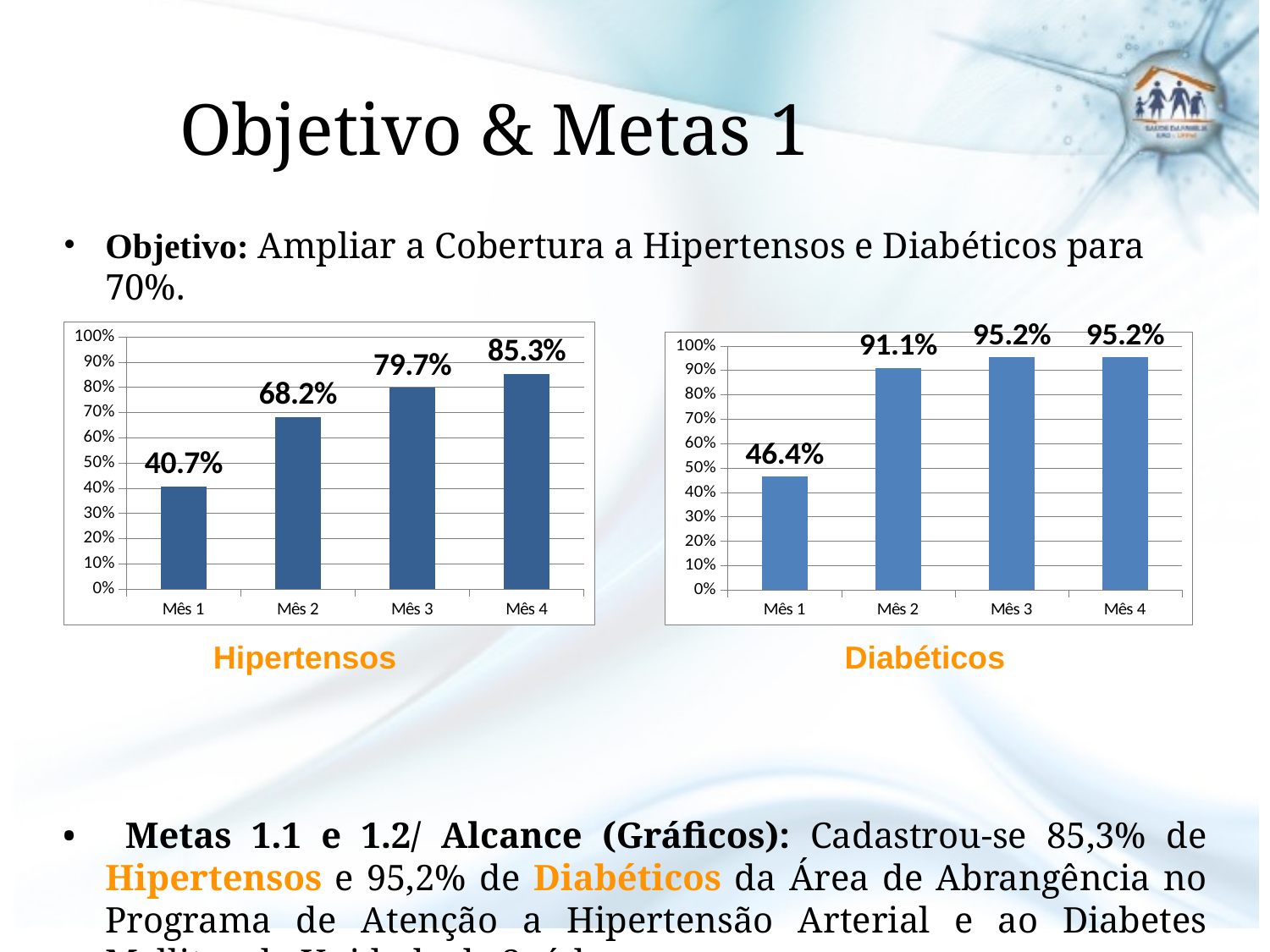
In the Hipertensos chart, do the values rise or fall from Mês 1 to Mês 4? rise Which is larger: the Mês 3 value in the Hipertensos chart or the Mês 3 value in the Diabéticos chart? Diabéticos In the Diabéticos chart, what is the value for Mês 2? 91.1% What kind of chart is the Hipertensos chart? bar chart In the Hipertensos chart, is the value for Mês 2 greater or less than 70%? less In the Hipertensos chart, what is the difference between the values for Mês 4 and Mês 1? 44.6% In the Diabéticos chart, which month has the lowest value? Mês 1 In the Diabéticos chart, what is the difference between the values for Mês 2 and Mês 1? 44.7% How many months are shown in the Diabéticos chart? 4 In the Hipertensos chart, what is the value for Mês 1? 40.7% In the Diabéticos chart, what is the value for Mês 4? 95.2% In the Hipertensos chart, which month has the highest value? Mês 4